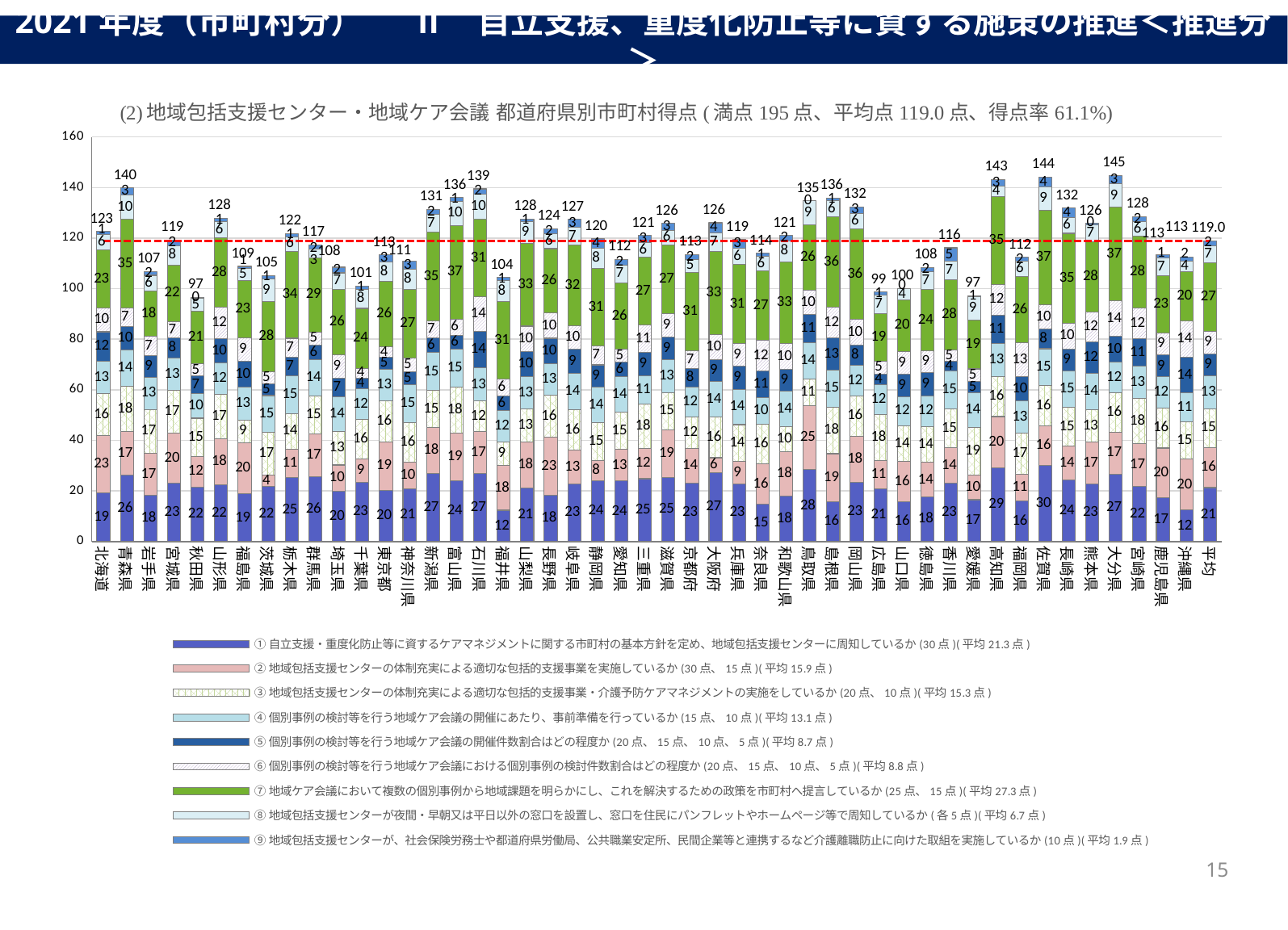
What is the total score shown above the bar for 大分県? 145 Which has the larger total score, 青森県 or 岩手県? 青森県 What kind of chart is shown on the slide? stacked bar chart What is the total score shown above the bar for 高知県? 143 Which prefecture has the highest total score? 大分県 What is the value of the bottom segment (series ①) for 福井県? 12 How many series does the legend list? 9 What is the total score shown above the bar for 石川県? 139 According to the chart title, what is the maximum possible score (満点)? 195 点 What is the total score shown for 平均? 119.0 Is the total score for 秋田県 greater or less than 100? less What is the difference between the total scores of 大分県 and 秋田県? 48